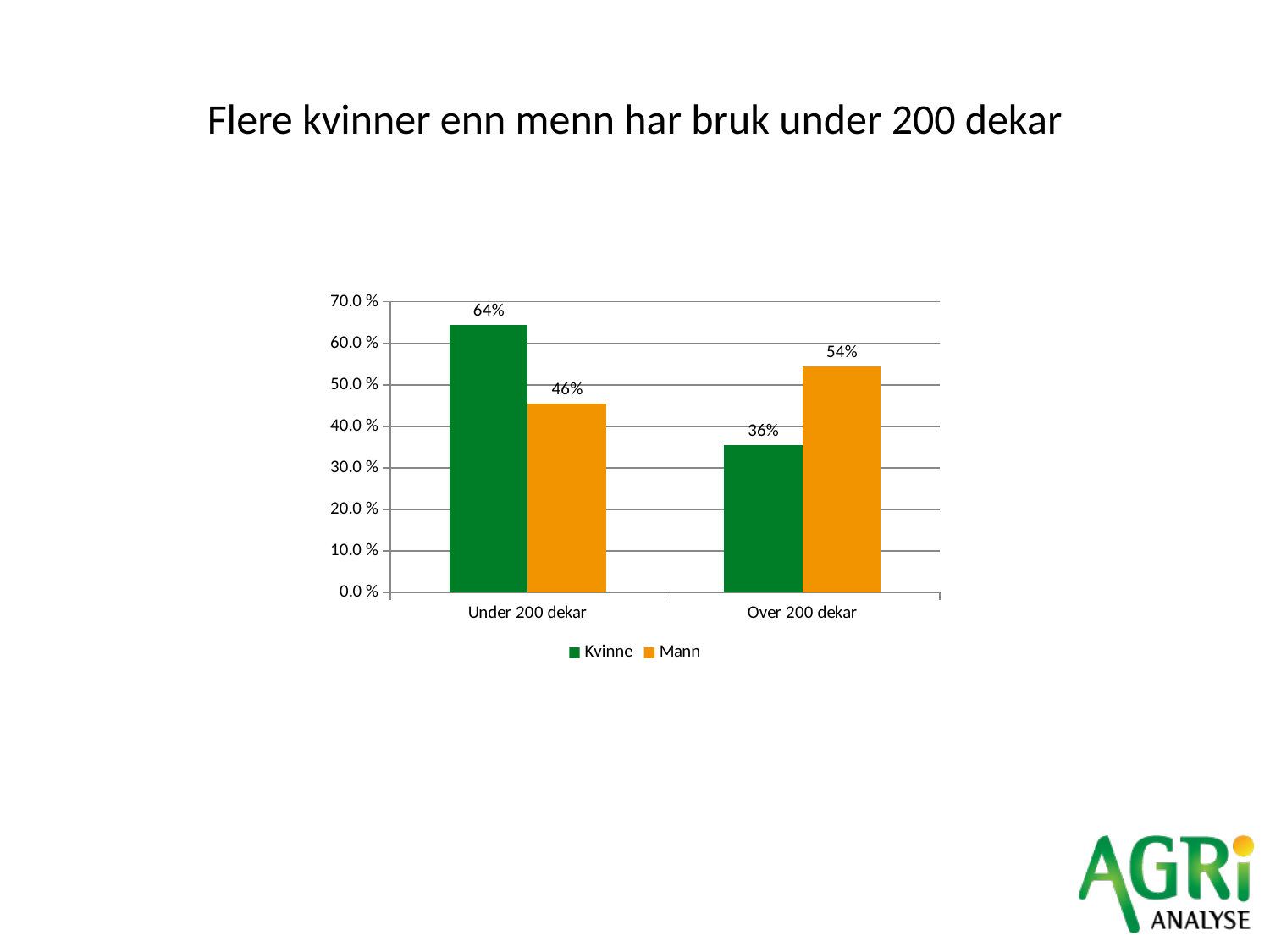
Which series has the lowest value in the Over 200 dekar category? Kvinne What kind of chart is shown on the slide? Bar chart What is the value for Kvinne in the Over 200 dekar category? 36% Which series has the highest value in the Under 200 dekar category? Kvinne How many categories are shown on the x axis? 2 What is the value for Mann in the Over 200 dekar category? 54% How many series does the legend list? 2 What is the value for Mann in the Under 200 dekar category? 46% Which is larger: the Mann value for Under 200 dekar or the Mann value for Over 200 dekar? Over 200 dekar What is the value for Kvinne in the Under 200 dekar category? 64% What is the difference between the Mann and Kvinne values in the Over 200 dekar category? 18% What is the difference between the Kvinne and Mann values in the Under 200 dekar category? 18%